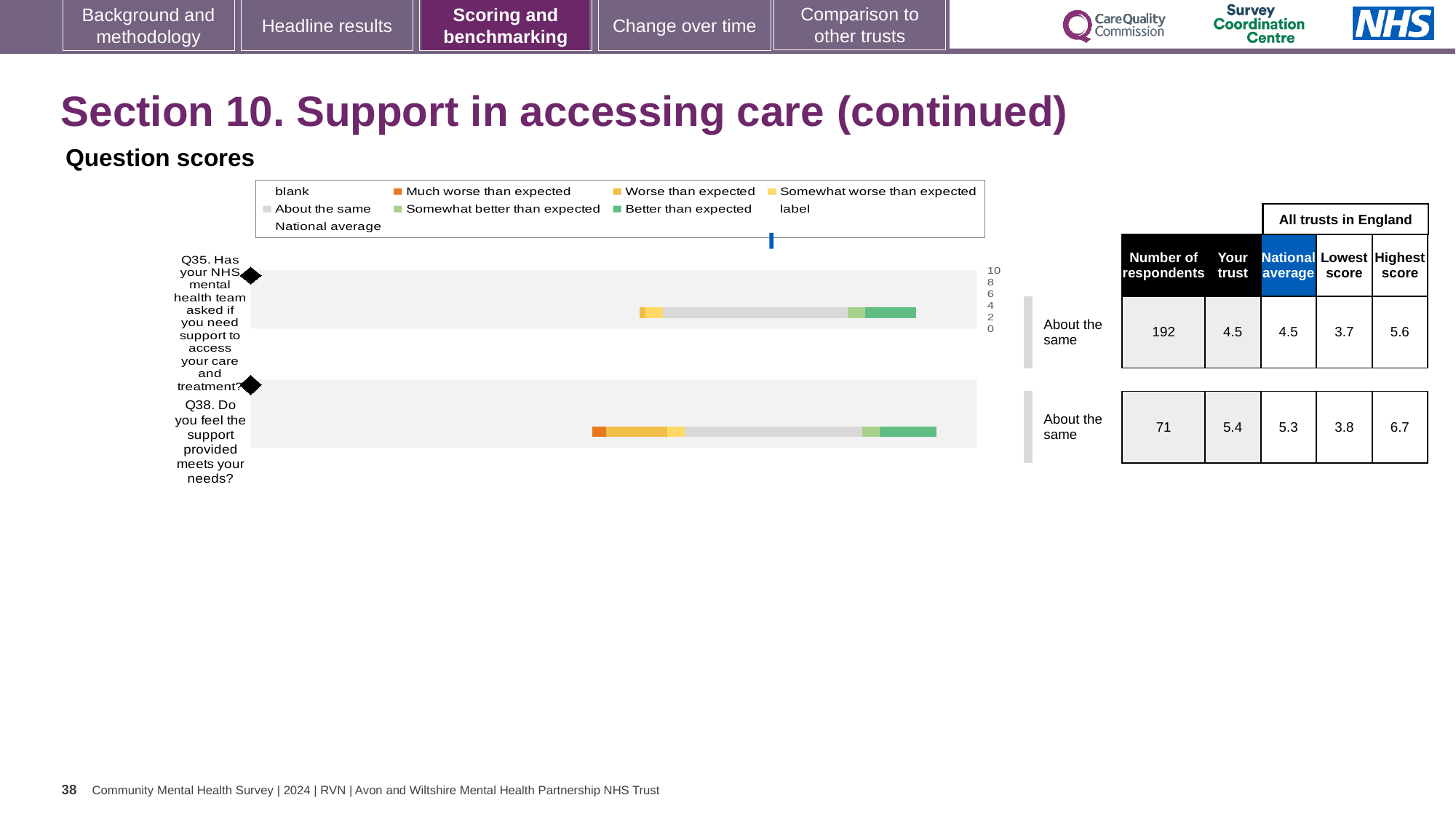
What is the highest score across all trusts in England for Q38? 6.7 Which colour in the legend represents 'Much worse than expected'? orange Which question has the higher 'Your trust' score, Q35 or Q38? Q38 What kind of chart is used to show the question scores? bar chart Is the 'Your trust' score for Q38 larger or smaller than the national average for Q38? larger What is the 'Your trust' score for Q38 (Do you feel the support provided meets your needs?)? 5.4 How is the trust's result for Q35 categorised relative to expectations? About the same What is the 'Your trust' score for Q35 (Has your NHS mental health team asked if you need support to access your care and treatment?)? 4.5 How many respondents answered Q35? 192 What is the national average score for Q38? 5.3 What is the difference between the highest and lowest scores across all trusts in England for Q38? 2.9 How many questions are plotted in the question scores chart? 2